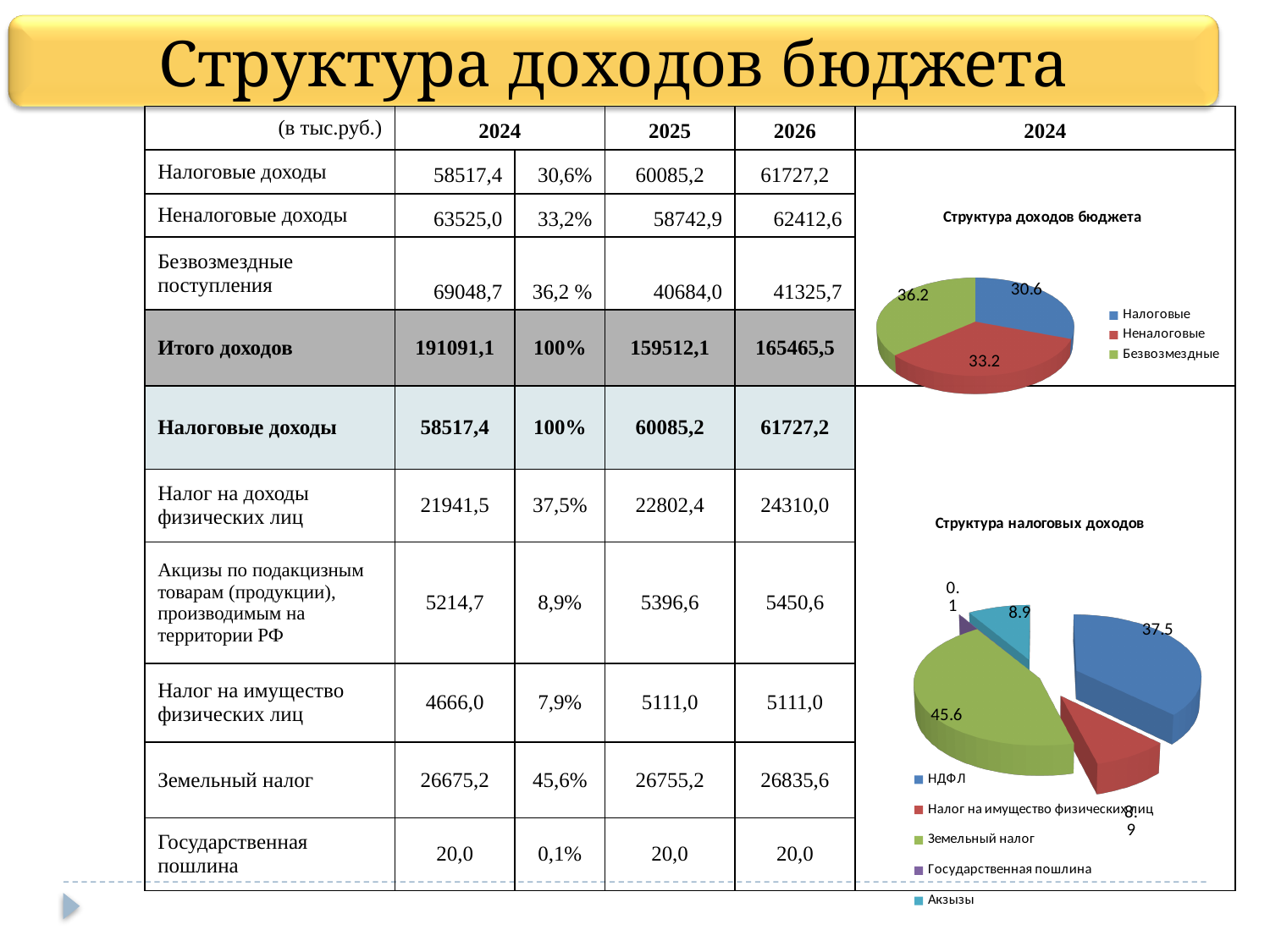
In the chart titled "Структура налоговых доходов", which slice is the largest? Земельный налог In the chart titled "Структура доходов бюджета", what is the value shown for the Неналоговые slice? 33.2 In the chart titled "Структура доходов бюджета", which slice is the smallest? Налоговые How many entries does the legend of the chart titled "Структура налоговых доходов" list? 5 In the chart titled "Структура доходов бюджета", what is the value shown for the Налоговые slice? 30.6 In the chart titled "Структура налоговых доходов", what is the value shown for the НДФЛ slice? 37.5 In the chart titled "Структура доходов бюджета", what is the difference between the Безвозмездные and Налоговые values? 5.6 What kind of chart is the chart titled "Структура доходов бюджета"? pie chart In the chart titled "Структура доходов бюджета", which slice is the largest? Безвозмездные In the chart titled "Структура налоговых доходов", which is larger, НДФЛ or Акцизы? НДФЛ In the chart titled "Структура налоговых доходов", what is the value shown for the Земельный налог slice? 45.6 How many slices does the chart titled "Структура доходов бюджета" have? 3